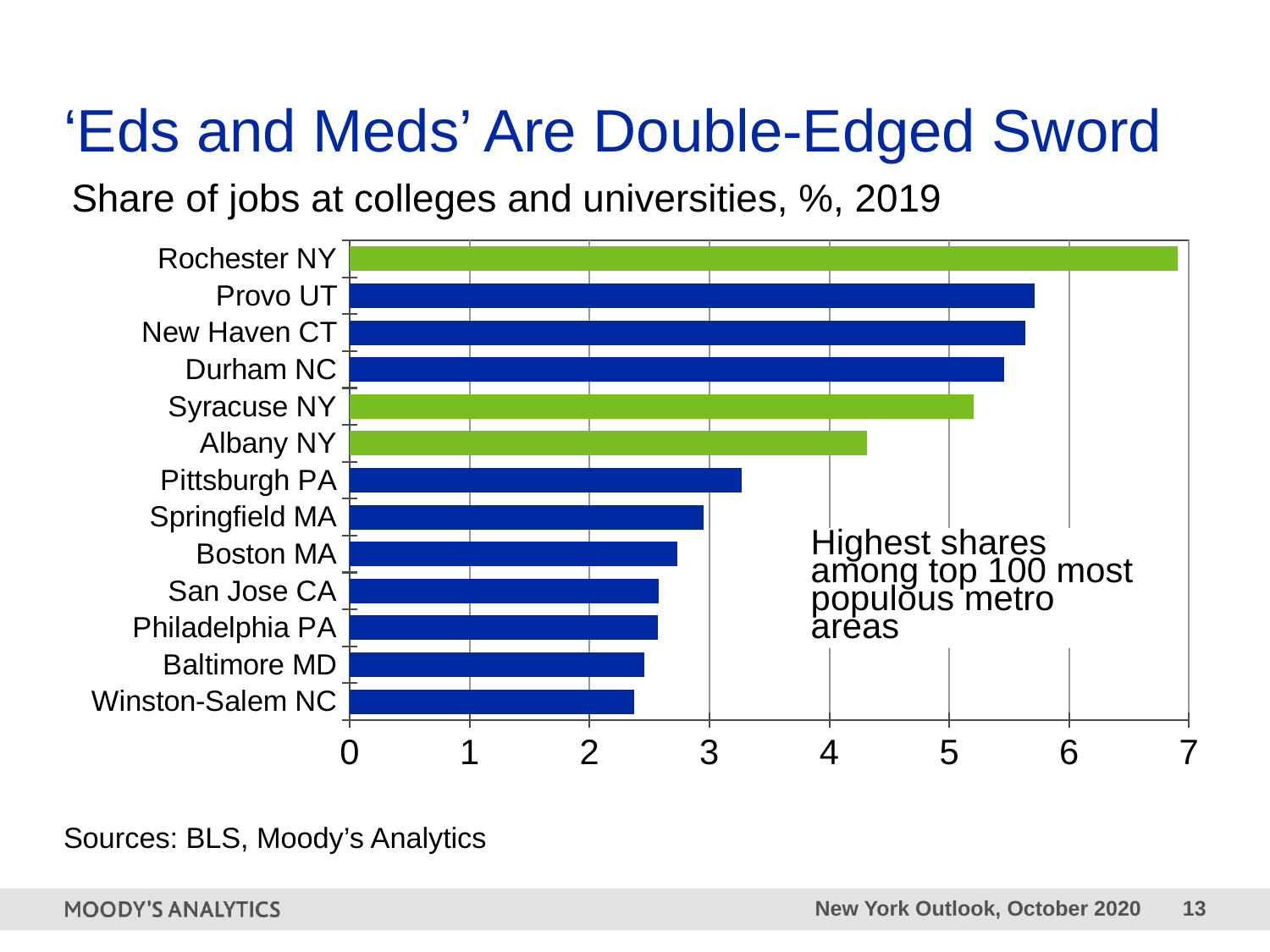
Which metro areas are shown with green bars in the chart? Rochester NY, Syracuse NY, Albany NY Which metro area has the lowest share of jobs at colleges and universities? Winston-Salem NC Which has a larger share of jobs at colleges and universities, Albany NY or Pittsburgh PA? Albany NY Is the value for Durham NC greater or less than 5? greater Is the value for Albany NY greater or less than 4? greater Is the value for Pittsburgh PA greater or less than 3? greater How many metro areas are plotted in the chart? 13 What kind of chart is shown on the slide? bar chart Which has a larger share of jobs at colleges and universities, Syracuse NY or Albany NY? Syracuse NY Which metro area has the highest share of jobs at colleges and universities? Rochester NY